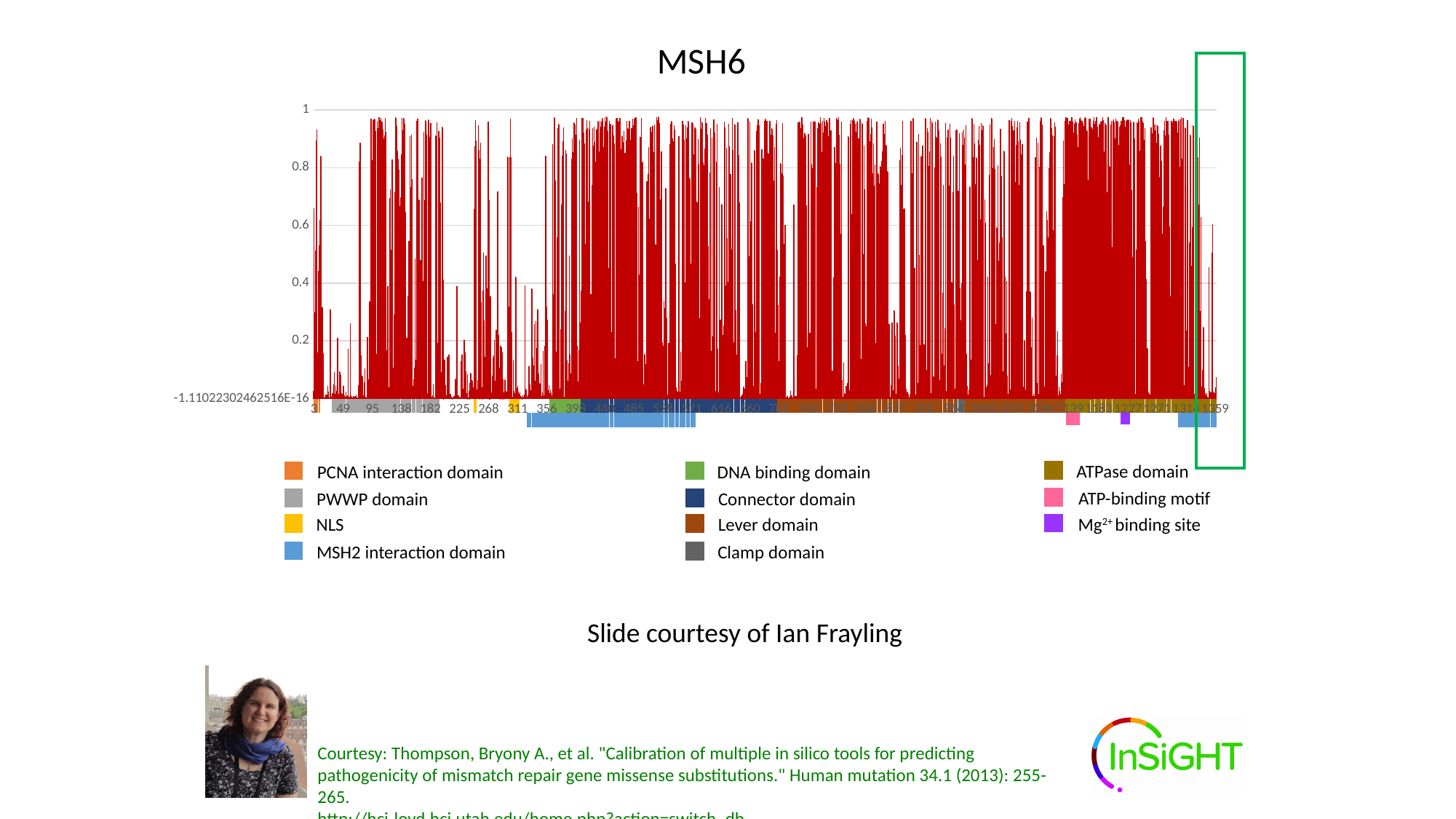
What kind of chart is shown on the slide? bar chart What is the title of the chart? MSH6 What is the highest tick value shown on the y axis of the MSH6 chart? 1 How many domain entries are listed in the legend below the MSH6 chart? 11 What is the last (rightmost) position label shown on the x axis of the MSH6 chart? 1359